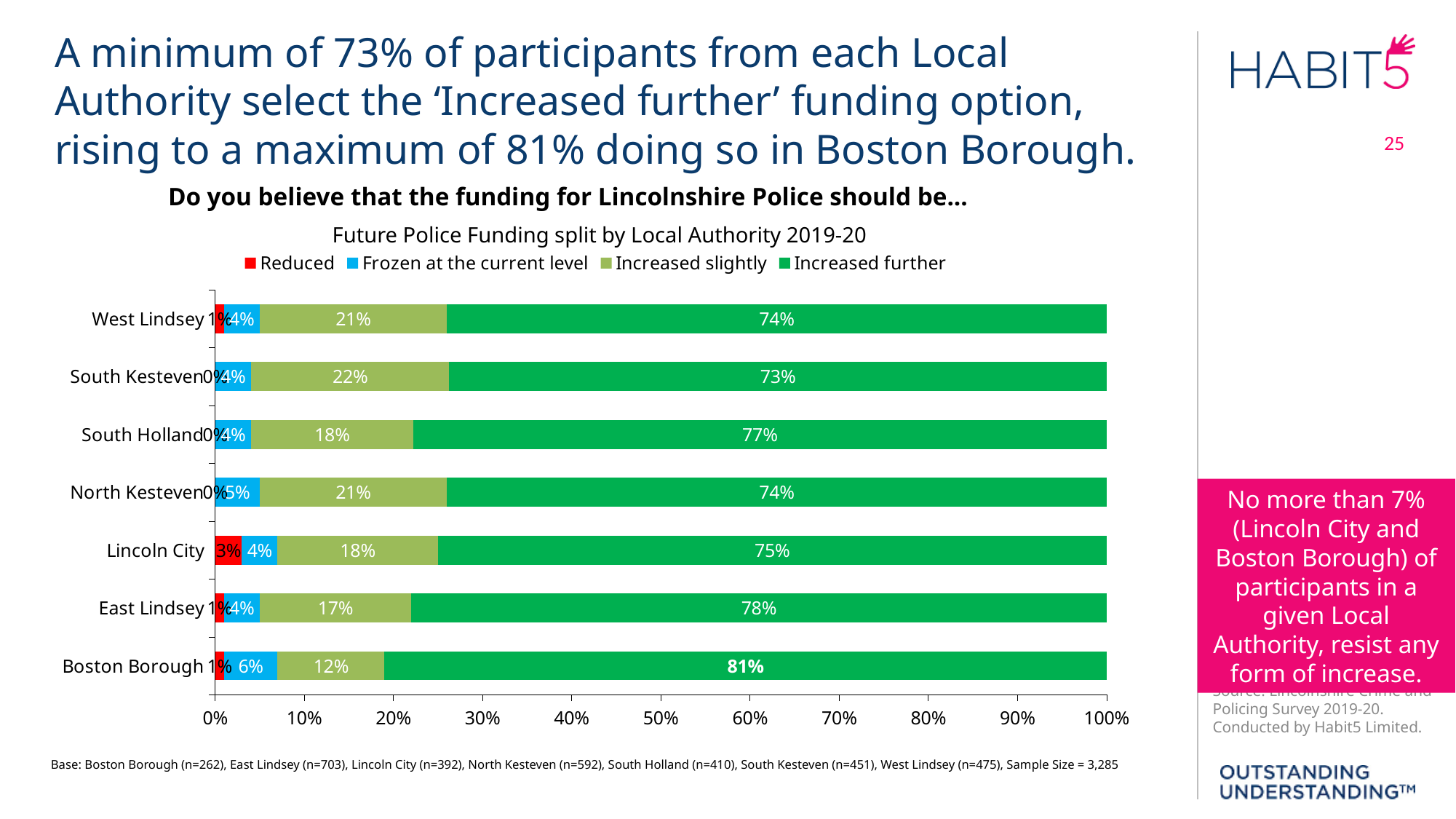
Which is larger: the 'Increased slightly' percentage for South Kesteven or for East Lindsey? South Kesteven What kind of chart is shown on the slide? Stacked bar chart Which Local Authority has the highest percentage for 'Increased further'? Boston Borough What percentage of participants in Lincoln City selected 'Reduced'? 3% Which Local Authority has the lowest percentage for 'Increased further'? South Kesteven How many series does the legend list? 4 How many Local Authorities are shown in the chart? 7 What percentage of participants in Boston Borough selected 'Increased further'? 81% What is the difference between the 'Increased further' percentages for Boston Borough and South Kesteven? 8 percentage points What is the title of the chart? Future Police Funding split by Local Authority 2019-20 What percentage of participants in South Holland selected 'Increased slightly'? 18% What percentage of participants in North Kesteven selected 'Frozen at the current level'? 5%